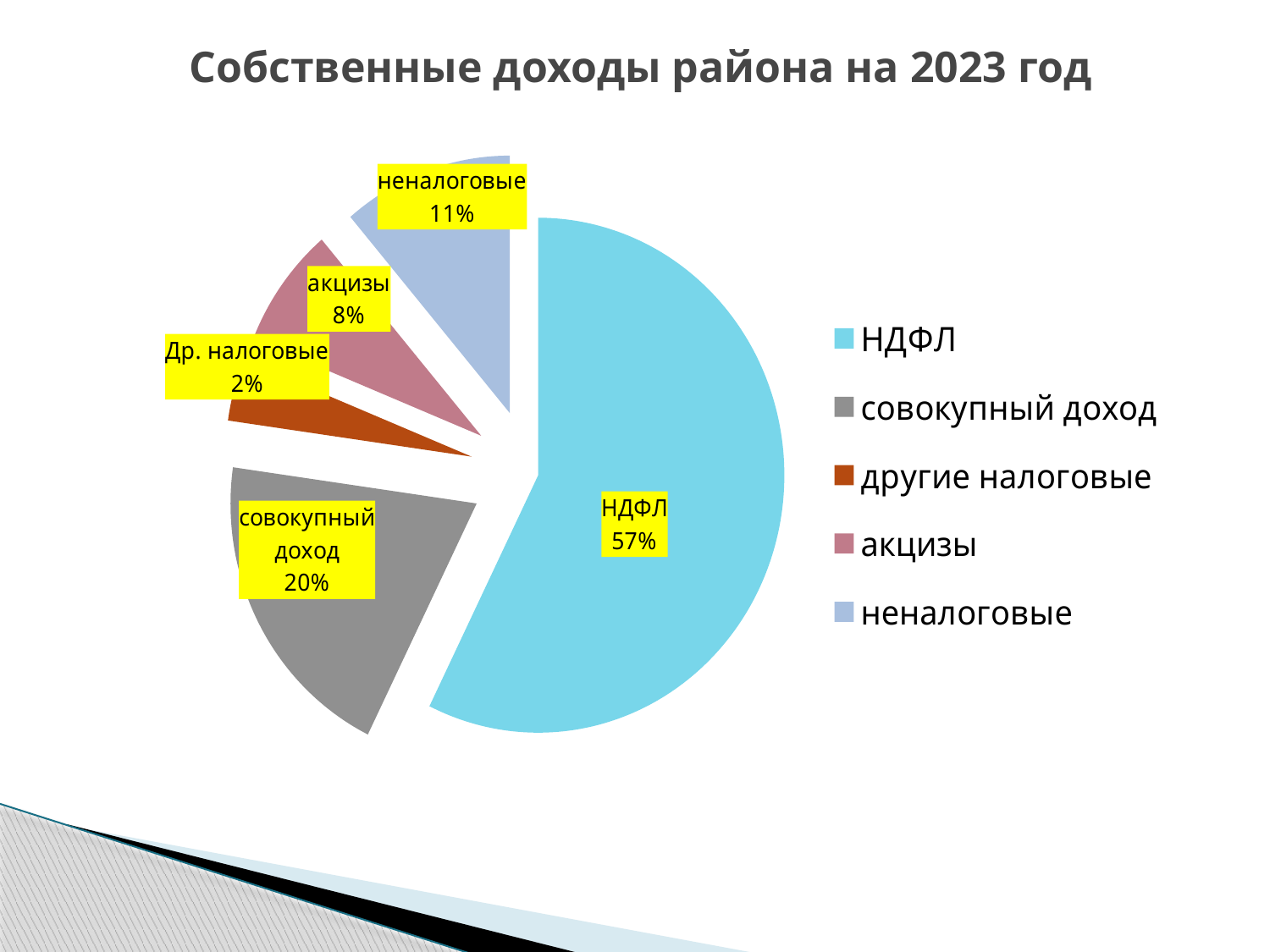
What is the value shown for Др. налоговые? 2% What is the value shown for неналоговые? 11% Which category has the smallest slice of the pie? Др. налоговые Which category has the largest slice of the pie? НДФЛ What is the difference between the shares of НДФЛ and совокупный доход? 37% What is the title of the chart? Собственные доходы района на 2023 год How many categories are shown in the pie chart? 5 Which is larger, the share of неналоговые or the share of акцизы? неналоговые What is the value shown for совокупный доход? 20% What kind of chart is shown on the slide? pie chart What share of the pie does НДФЛ account for? 57% What is the value shown for акцизы? 8%